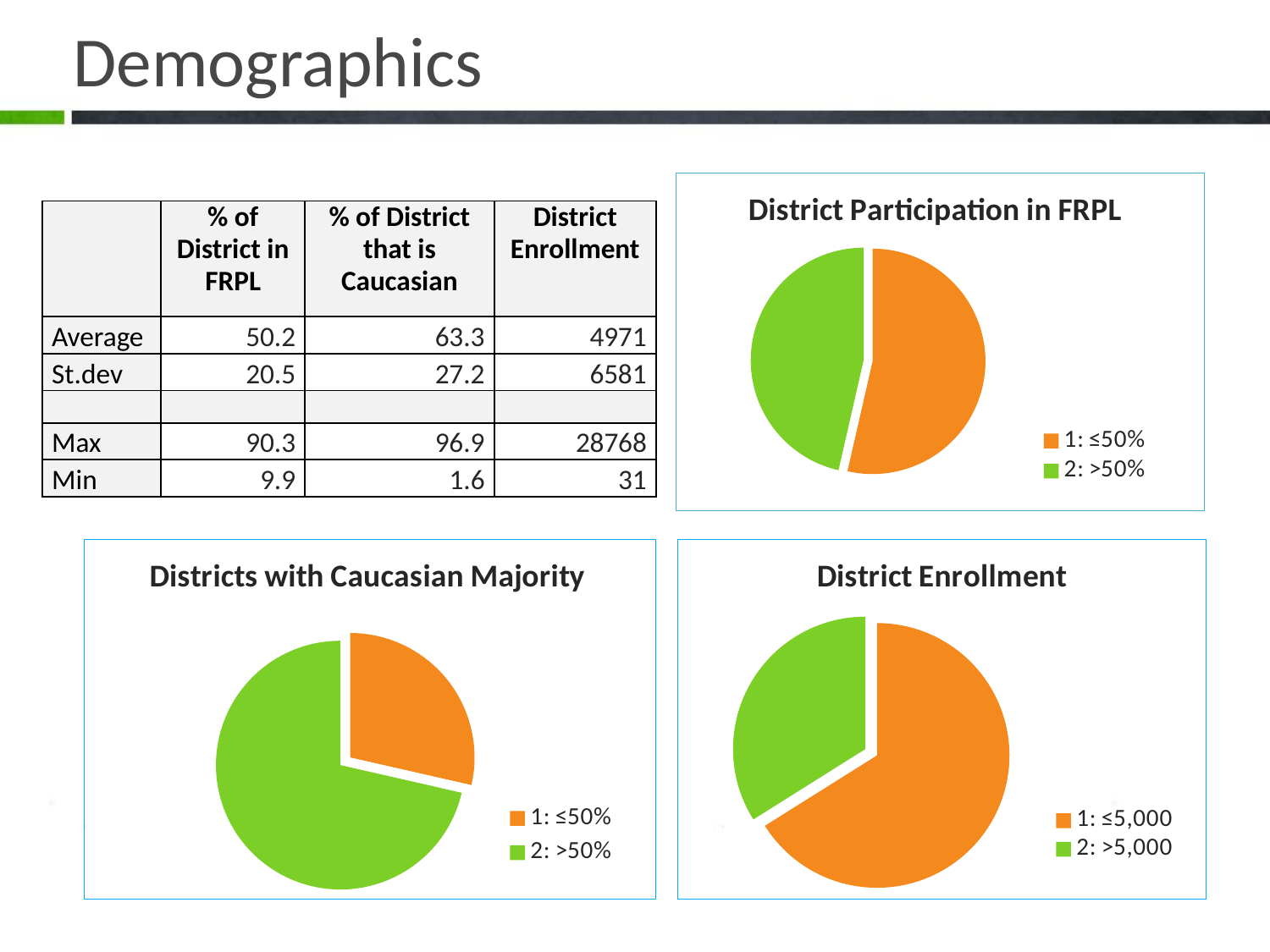
What kind of chart is the "District Participation in FRPL" chart? pie chart In the "Districts with Caucasian Majority" chart, which category has the largest slice? 2: >50% In the "District Participation in FRPL" chart, what colour is the "1: ≤50%" slice? orange How many slices does the "Districts with Caucasian Majority" pie chart have? 2 How many pie charts are shown on the slide? 3 How many entries does the legend of the "District Participation in FRPL" chart list? 2 In the "District Enrollment" pie chart, which slice is larger: "1: ≤5,000" or "2: >5,000"? 1: ≤5,000 In the "Districts with Caucasian Majority" chart, which category has the smallest slice? 1: ≤50% What are the two legend entries of the "District Enrollment" pie chart? 1: ≤5,000 and 2: >5,000 In the "District Enrollment" pie chart, which category has the smallest slice? 2: >5,000 In the "Districts with Caucasian Majority" chart, which slice is larger: "1: ≤50%" or "2: >50%"? 2: >50% In the "District Enrollment" pie chart, which category has the largest slice? 1: ≤5,000